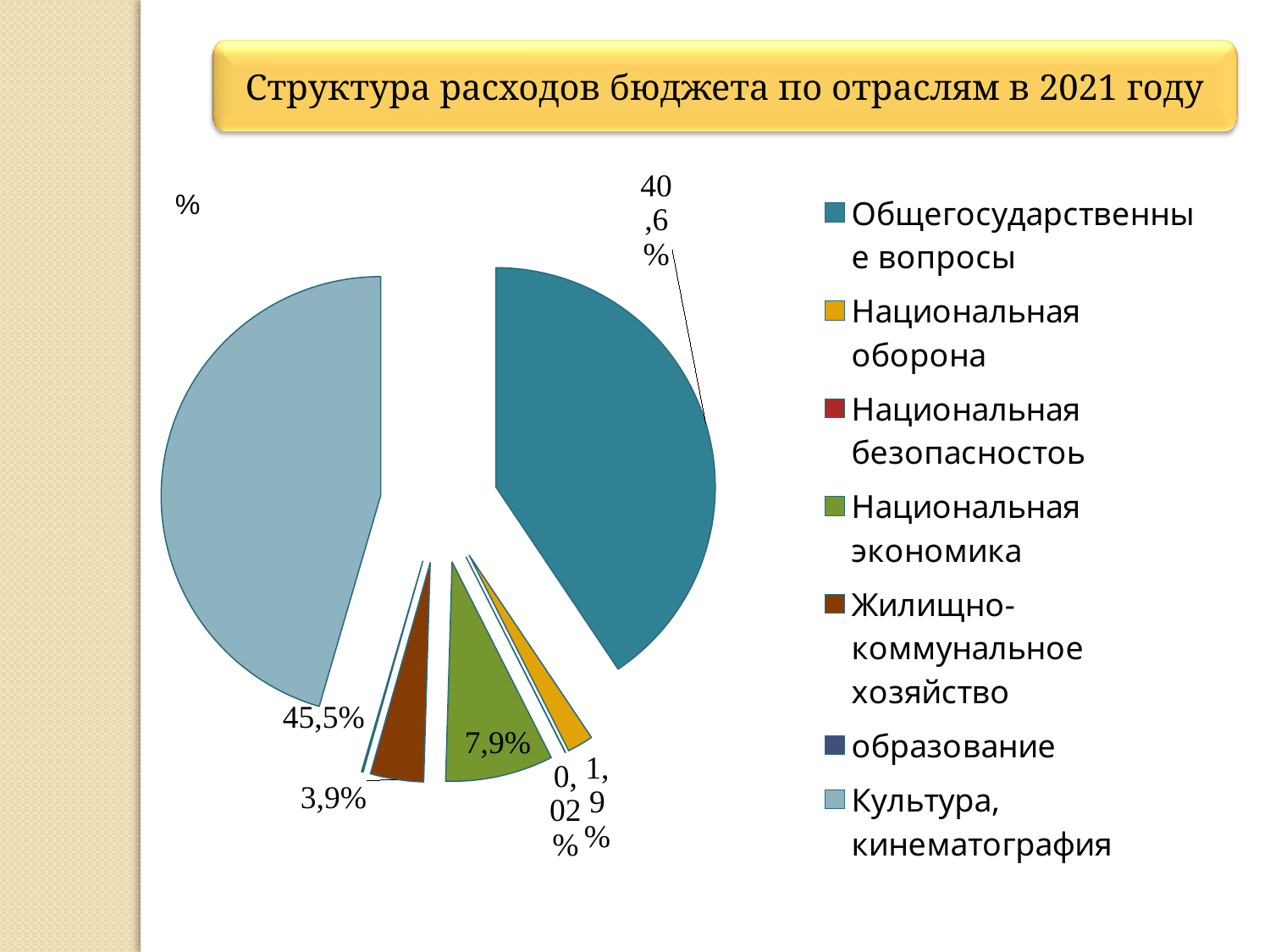
What share of the budget expenditure goes to Жилищно-коммунальное хозяйство? 3,9% What kind of chart is shown on the slide? pie chart What share of the budget expenditure goes to Национальная оборона? 1,9% How many categories does the legend list? 7 What is the difference between the shares of Национальная экономика and Жилищно-коммунальное хозяйство? 4,0% What share of the budget expenditure goes to Культура, кинематография? 45,5% What share of the budget expenditure goes to Национальная экономика? 7,9% By how many percentage points does the share of Культура, кинематография exceed that of Общегосударственные вопросы? 4,9% What share of the budget expenditure goes to Общегосударственные вопросы? 40,6% Which category has the largest share of the budget expenditure? Культура, кинематография Which has the larger share: Общегосударственные вопросы or Культура, кинематография? Культура, кинематография What is the title of the slide? Структура расходов бюджета по отраслям в 2021 году